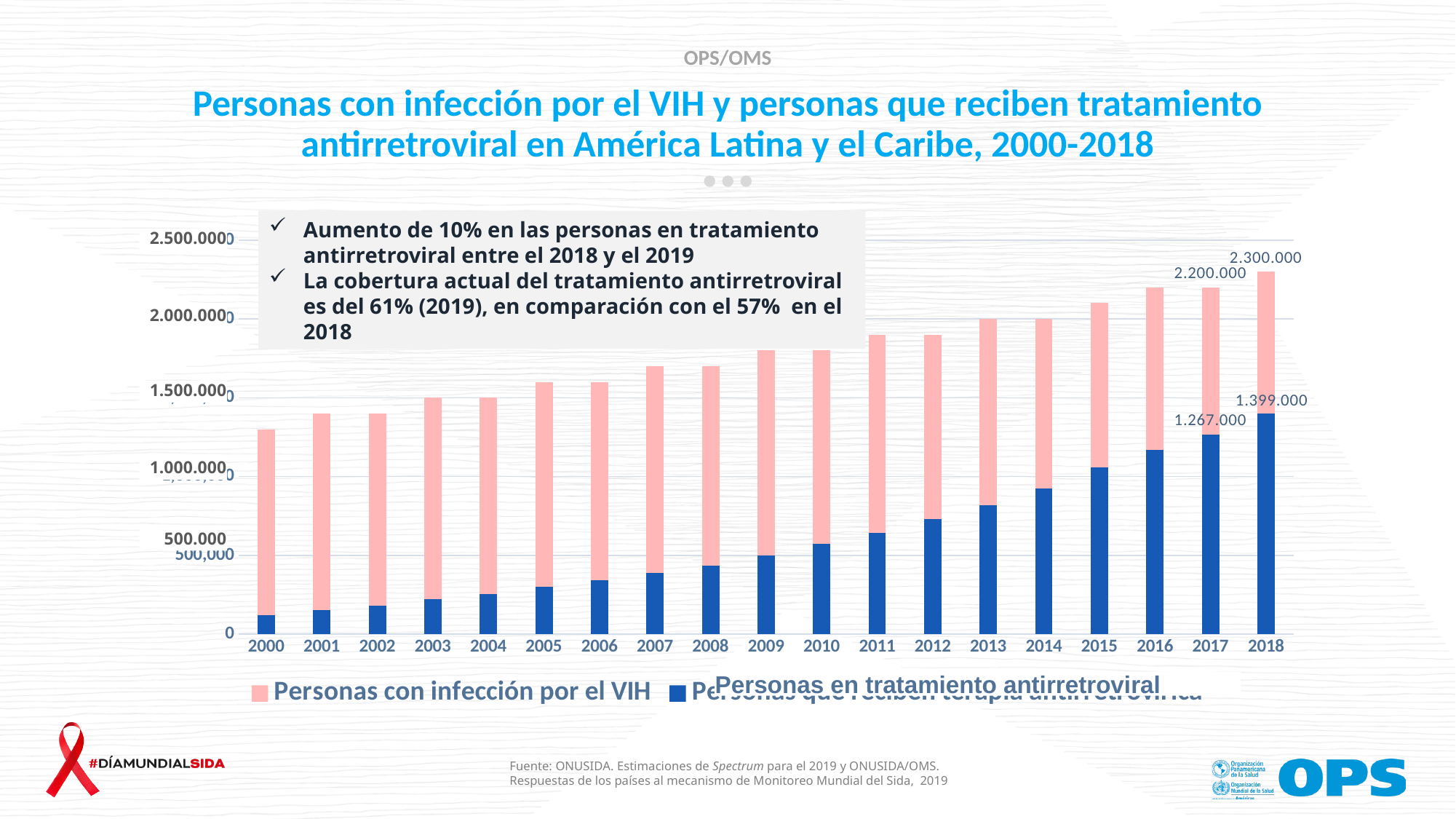
What kind of chart is shown on the slide? Bar chart What is the difference between Personas con infección por el VIH in 2018 and in 2017? 100.000 In which year is the value for Personas en tratamiento antirretroviral lowest? 2000 What is the value for Personas en tratamiento antirretroviral in 2017? 1.267.000 Is the value for Personas en tratamiento antirretroviral in 2010 greater or less than 1.000.000? less How many years are shown on the x axis of the chart? 19 In which year is the value for Personas en tratamiento antirretroviral highest? 2018 What is the value for Personas con infección por el VIH in 2017? 2.200.000 What is the value for Personas en tratamiento antirretroviral in 2018? 1.399.000 By how much did the number of Personas en tratamiento antirretroviral increase from 2017 to 2018? 132.000 How many series does the chart's legend list? 2 What is the value for Personas con infección por el VIH in 2018? 2.300.000